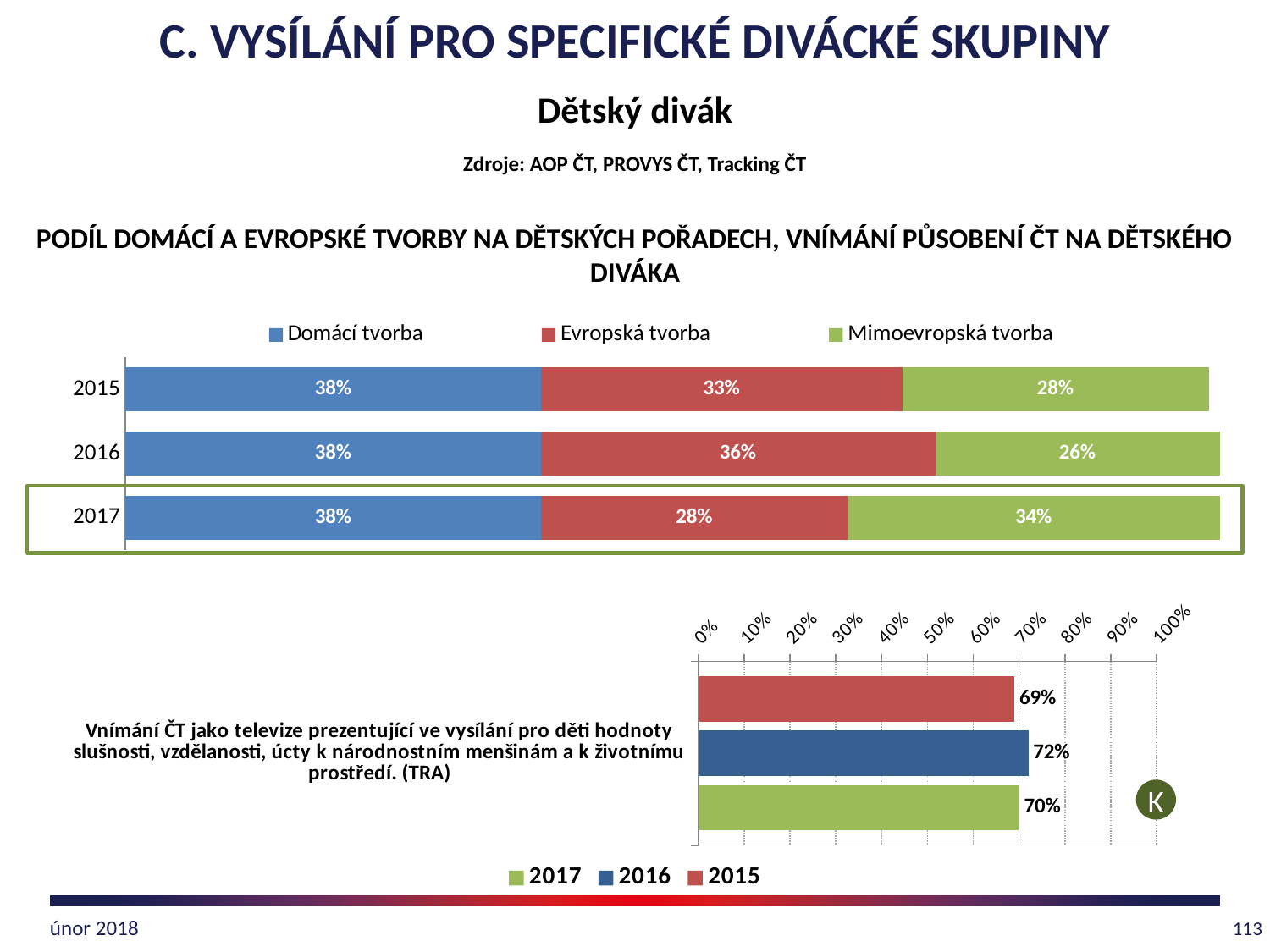
In the bottom bar chart, which year has the lowest value? 2015 In the bottom bar chart, what is the value for 2016? 72% In the top stacked bar chart, how many series does the legend list? 3 In the top stacked bar chart, what is the value for Mimoevropská tvorba in 2017? 34% In the top stacked bar chart, what is the value for Domácí tvorba in 2015? 38% In the top stacked bar chart, what is the value for Evropská tvorba in 2016? 36% In the top stacked bar chart, does the value for Domácí tvorba rise, fall or stay the same from 2015 to 2017? stays the same In the top stacked bar chart, what is the difference between Evropská tvorba in 2016 and in 2017? 8% In the top stacked bar chart, which year has the highest value for Mimoevropská tvorba? 2017 What type of chart is the bottom chart? bar chart In the top stacked bar chart, which year has the lowest value for Evropská tvorba? 2017 In the bottom bar chart, what is the difference between the values for 2016 and 2015? 3%